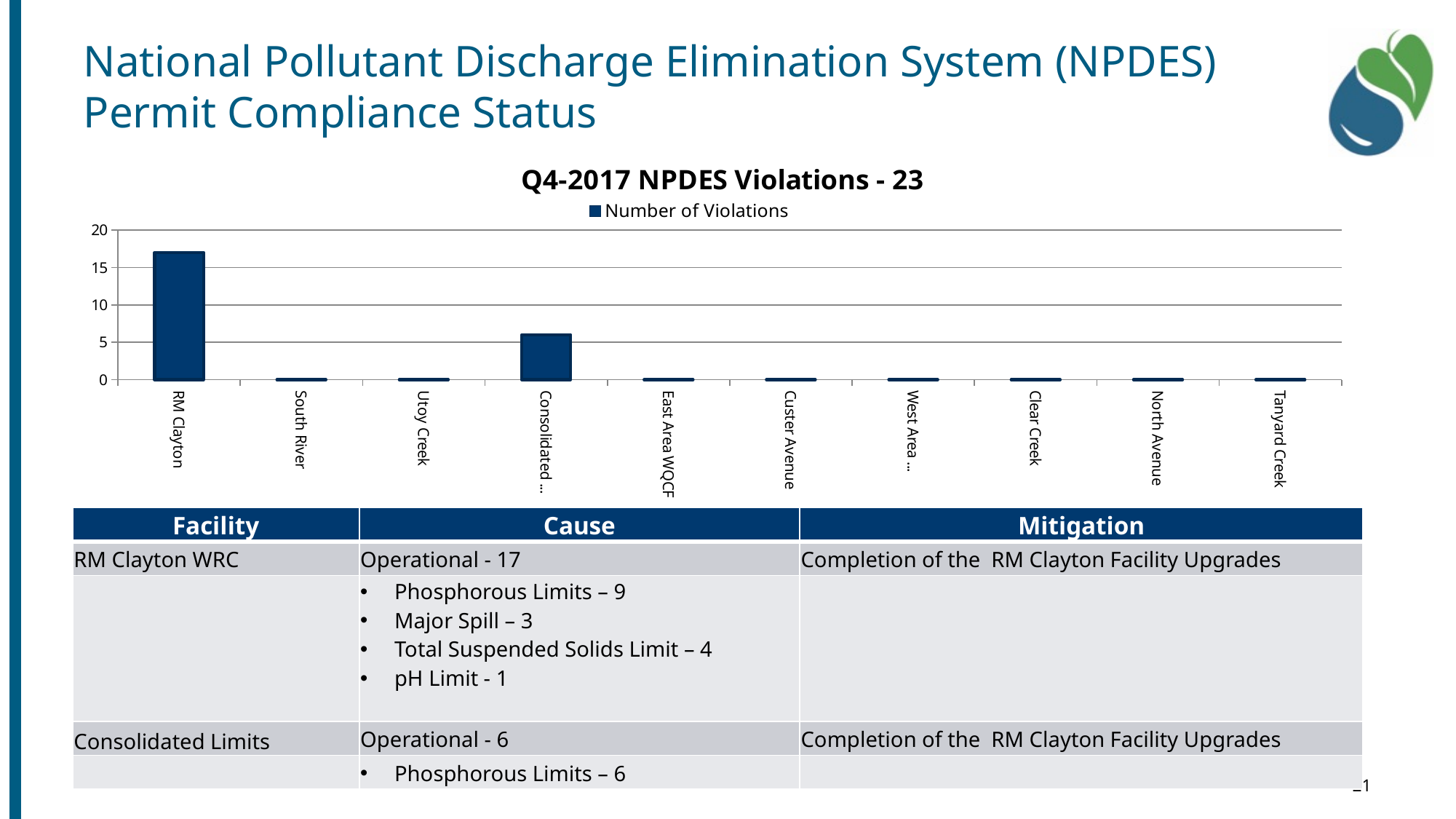
What series name is shown in the chart's legend? Number of Violations Which facility has the highest number of violations in the chart? RM Clayton What is the number of violations for Tanyard Creek in the chart? 0 What kind of chart is shown on the slide? bar chart What is the title of the chart? Q4-2017 NPDES Violations - 23 Is the number of violations for RM Clayton greater or less than 15? greater How many facilities are shown along the x axis of the chart? 10 Which has more violations in the chart, RM Clayton or Consolidated? RM Clayton What is the number of violations for South River in the chart? 0 How many series does the chart's legend list? 1 Is the number of violations for Consolidated greater or less than 10? less Is the number of violations for Consolidated greater or less than 5? greater